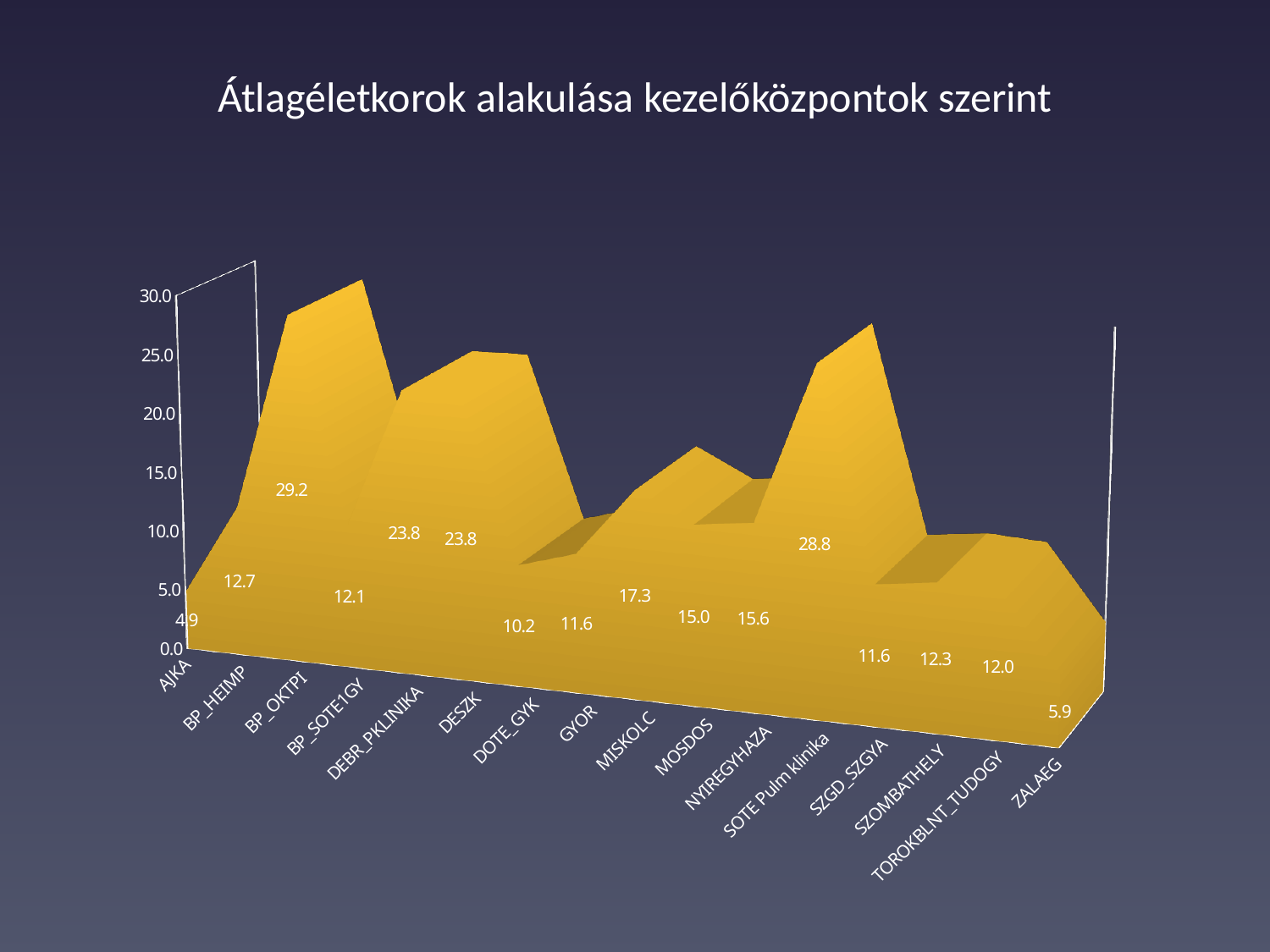
What is the difference between the values for BP_OKTPI and SOTE Pulm klinika? 0.4 What is the value for SOTE Pulm klinika? 28.8 What is the value for ZALAEG? 5.9 What is the title of the chart? Átlagéletkorok alakulása kezelőközpontok szerint How many treatment centres are shown on the x axis? 16 What is the value for BP_OKTPI? 29.2 What is the difference between the values for MISKOLC and MOSDOS? 2.3 What is the value for MISKOLC? 17.3 Which is larger, the value for DESZK or the value for DOTE_GYK? DESZK Which treatment centre has the lowest value? AJKA Which treatment centre has the highest value? BP_OKTPI What kind of chart is this? Area chart